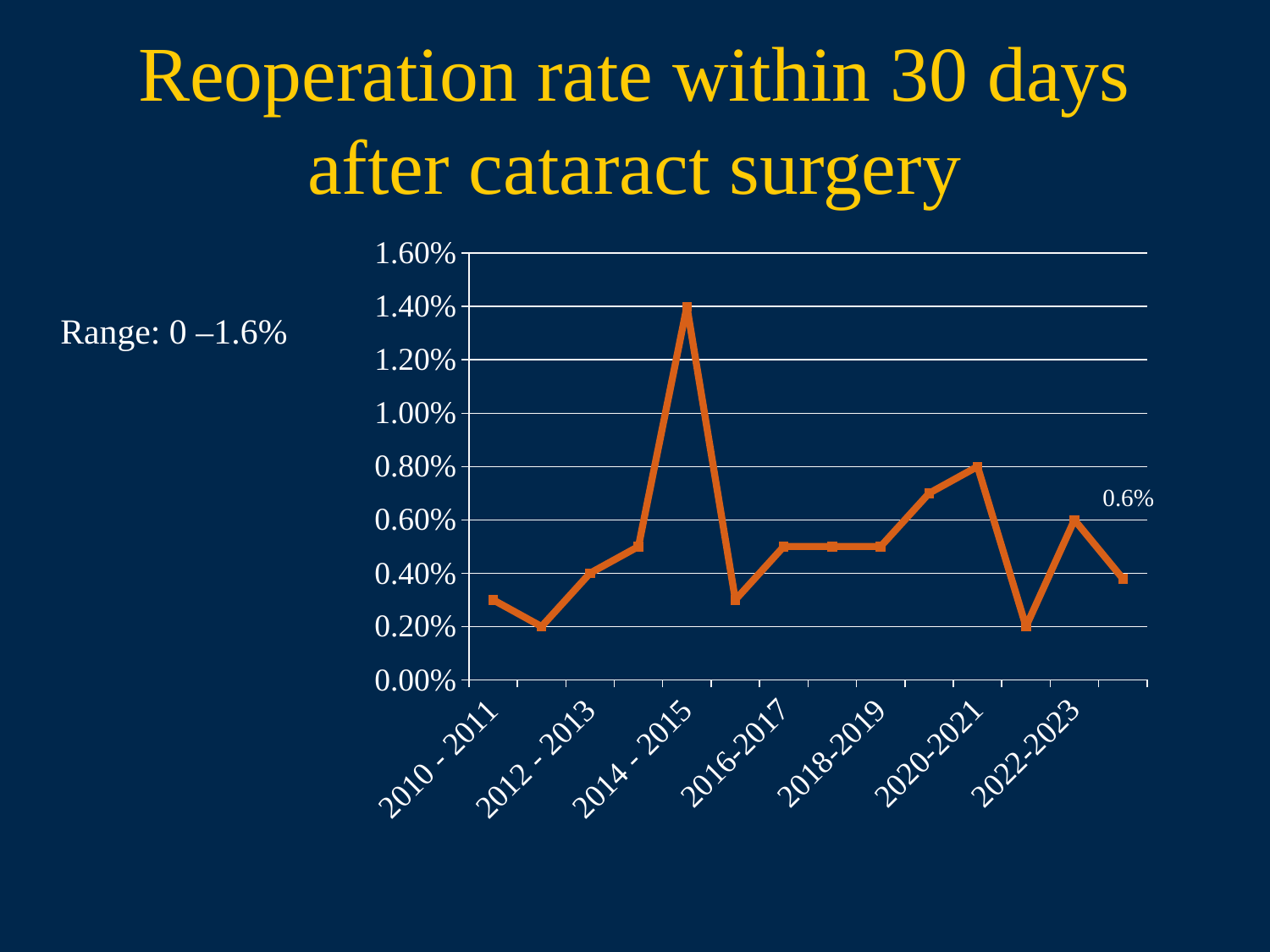
Which is higher, the rate for 2014 - 2015 or the rate for 2020-2021? 2014 - 2015 How many period labels are shown on the x axis? 7 What is the reoperation rate for 2022-2023? 0.6% Which period has the highest reoperation rate? 2014 - 2015 Is the value for 2010 - 2011 greater or less than 0.40%? less Is the value for 2016-2017 greater or less than 0.40%? greater What is the reoperation rate for 2014 - 2015? 1.40% What kind of chart is shown on the slide? line chart What is the reoperation rate for 2012 - 2013? 0.40% What is the difference between the rate for 2014 - 2015 and the rate for 2020-2021? 0.60% What is the reoperation rate for 2020-2021? 0.80% What is the title of the slide containing the chart? Reoperation rate within 30 days after cataract surgery